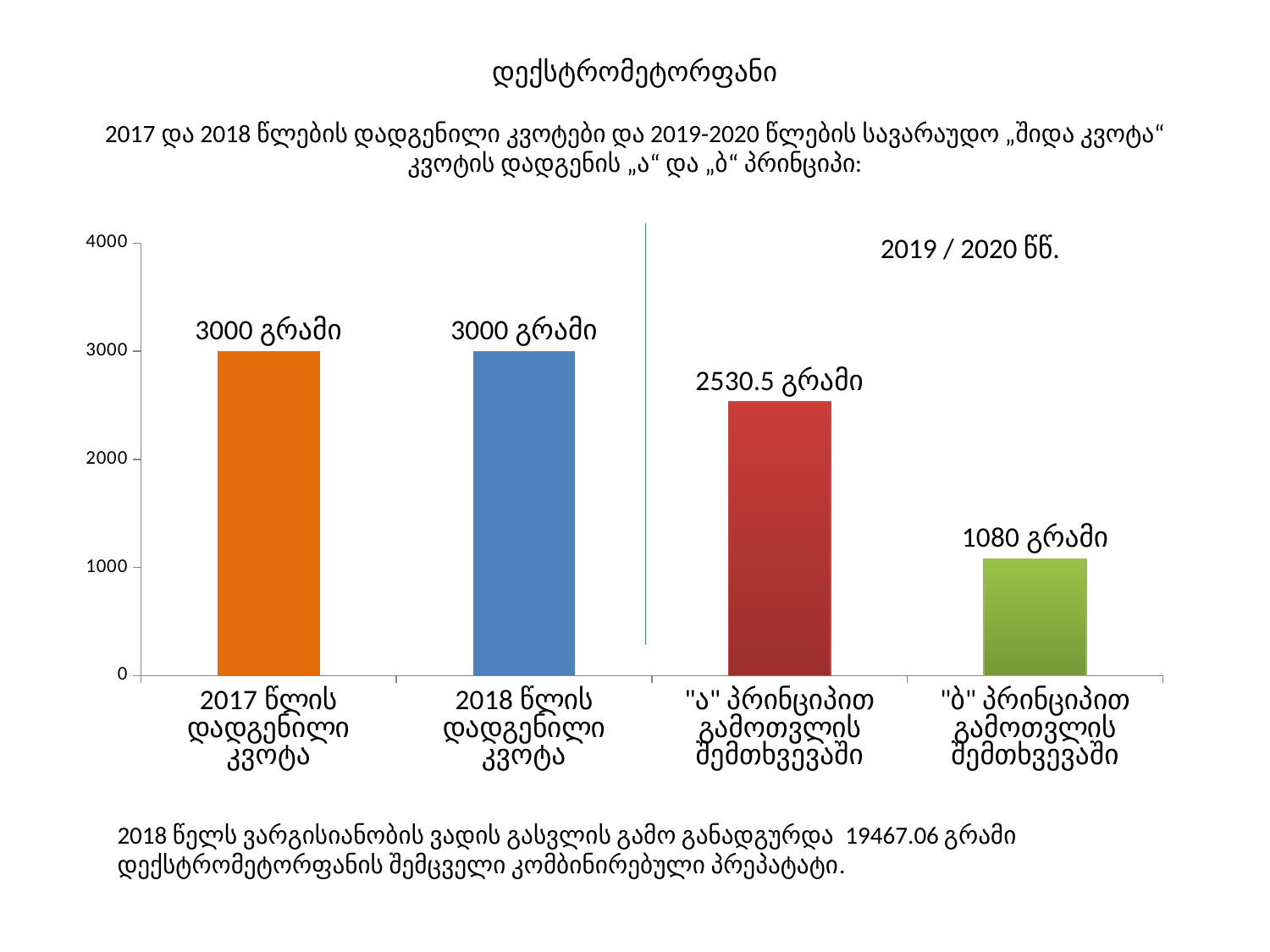
What value is shown for the bar labelled "2018 წლის დადგენილი კვოტა"? 3000 გრამი What is the title at the top of the slide? დექსტრომეტორფანი How many bars are plotted in the chart? 4 What kind of chart is shown on the slide? bar chart Is the value for ""ა" პრინციპით გამოთვლის შემთხვევაში" greater or less than 2000? greater What value is shown for the bar labelled "2017 წლის დადგენილი კვოტა"? 3000 გრამი What is the difference between the 2018 quota ("2018 წლის დადგენილი კვოტა") and the value calculated by principle "ა"? 469.5 გრამი What value is shown for the bar labelled ""ა" პრინციპით გამოთვლის შემთხვევაში"? 2530.5 გრამი Which category has the lowest value in the chart? "ბ" პრინციპით გამოთვლის შემთხვევაში Which is larger: the value for ""ა" პრინციპით გამოთვლის შემთხვევაში" or the value for ""ბ" პრინციპით გამოთვლის შემთხვევაში"? "ა" პრინციპით გამოთვლის შემთხვევაში What value is shown for the bar labelled ""ბ" პრინციპით გამოთვლის შემთხვევაში"? 1080 გრამი What is the difference between the value for ""ა" პრინციპით გამოთვლის შემთხვევაში" and the value for ""ბ" პრინციპით გამოთვლის შემთხვევაში"? 1450.5 გრამი